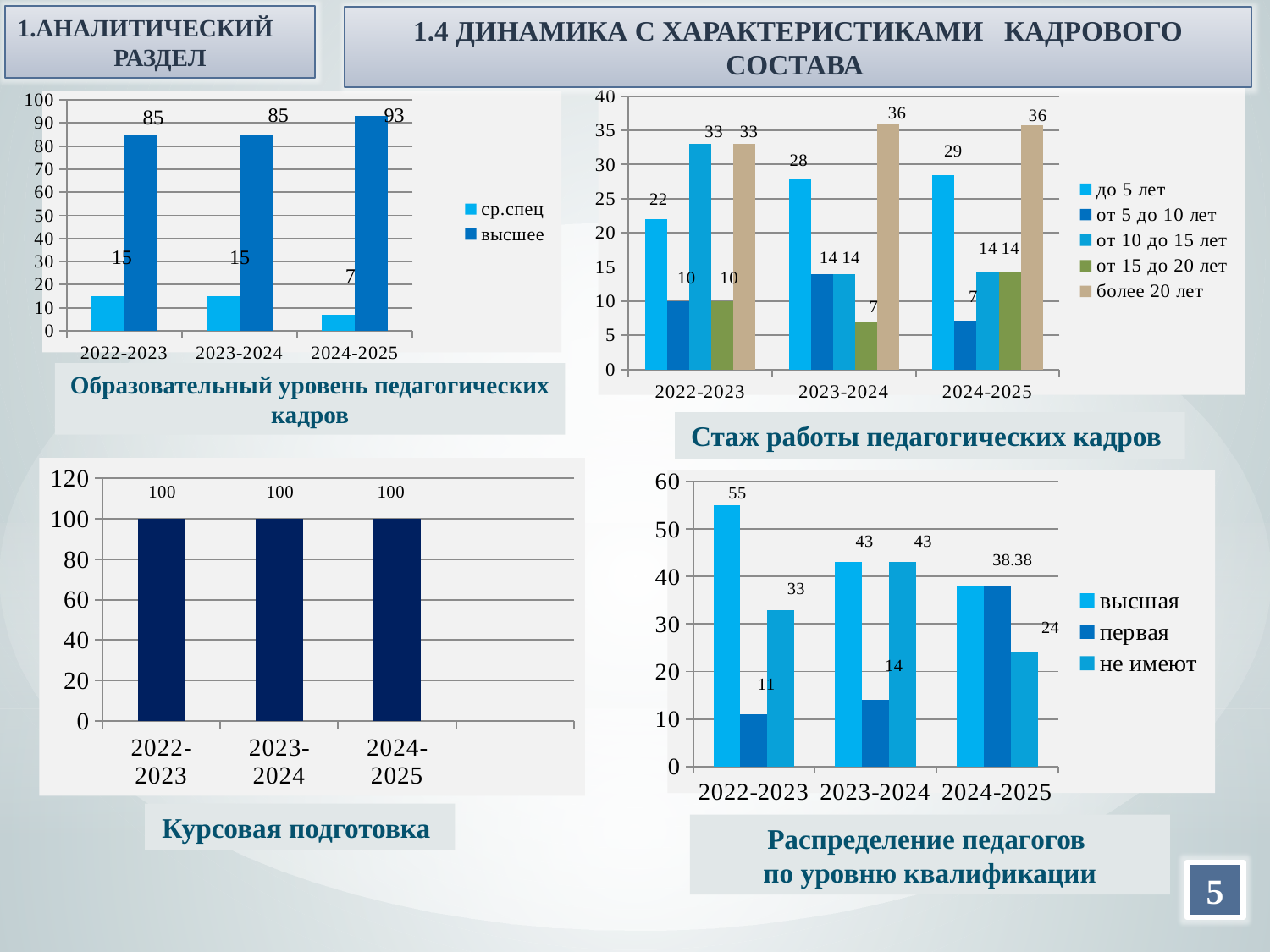
In the chart 'Распределение педагогов по уровню квалификации', what is the value for 'высшая' in 2022-2023? 55 In the chart 'Курсовая подготовка', how many categories are shown on the x axis? 3 In the chart 'Стаж работы педагогических кадров', which series has the highest value in 2024-2025? более 20 лет In the chart 'Образовательный уровень педагогических кадров', what is the difference between 'высшее' and 'ср.спец' in 2024-2025? 86 In the chart 'Образовательный уровень педагогических кадров', what is the value for 'ср.спец' in 2022-2023? 15 In the chart 'Стаж работы педагогических кадров', does the value for 'до 5 лет' rise or fall from 2022-2023 to 2024-2025? rise What kind of chart is 'Распределение педагогов по уровню квалификации'? bar chart In the chart 'Курсовая подготовка', what is the value for 2023-2024? 100 In the chart 'Стаж работы педагогических кадров', what is the value for 'до 5 лет' in 2023-2024? 28 In the chart 'Стаж работы педагогических кадров', how many series does the legend list? 5 In the chart 'Распределение педагогов по уровню квалификации', which is larger in 2023-2024: 'высшая' or 'первая'? высшая In the chart 'Образовательный уровень педагогических кадров', what is the value for 'высшее' in 2024-2025? 93